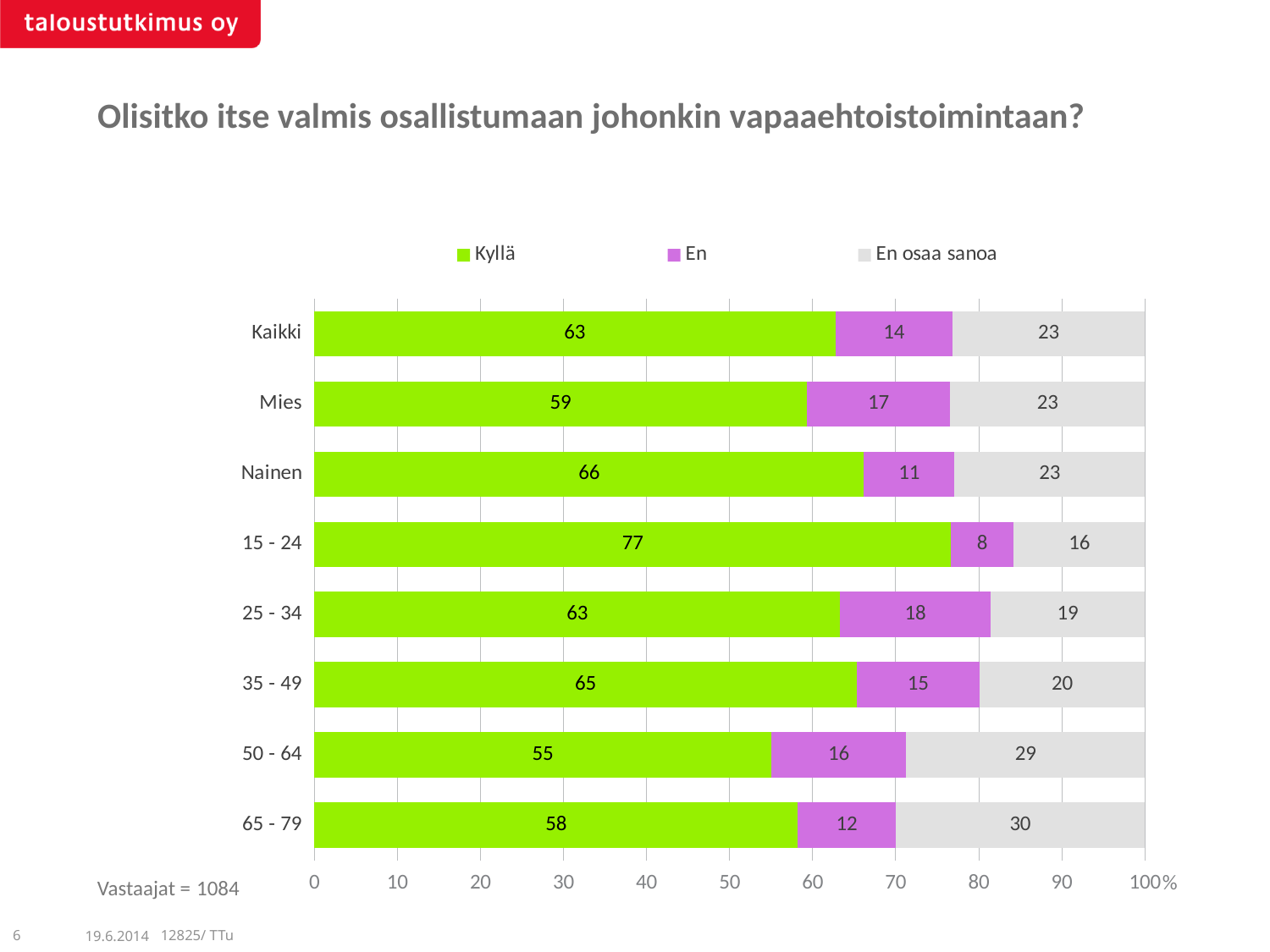
How many series does the legend list? 3 Which series is shown in green in the legend? Kyllä Which category has the highest Kyllä value? 15 - 24 What is the total of the stacked bar for Kaikki? 100 What kind of chart is shown on the slide? Stacked bar chart What is the Kyllä value for the 15 - 24 group? 77 What is the En osaa sanoa value for the 65 - 79 group? 30 Which category has the lowest Kyllä value? 50 - 64 Which has a larger En osaa sanoa value, 50 - 64 or 25 - 34? 50 - 64 What is the difference between the Kyllä values for Nainen and Mies? 7 What is the En value for Mies? 17 How many categories are shown on the y axis? 8